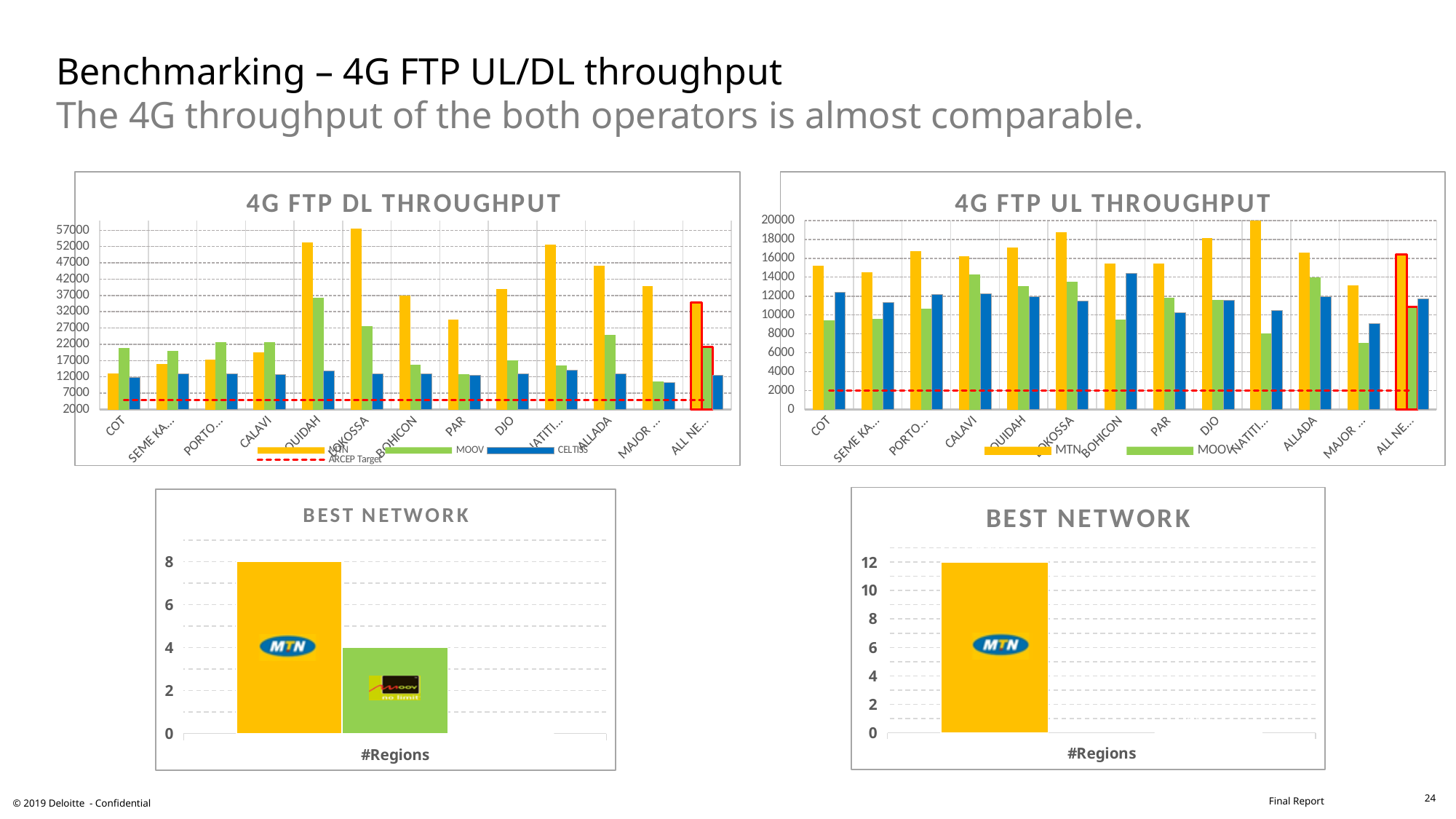
In the 4G FTP UL THROUGHPUT chart, is the MOOV value for ALLADA greater or less than 12000? greater What kind of chart is the 4G FTP DL THROUGHPUT chart? combination bar and line chart In the bottom-left BEST NETWORK chart, what is the value for MTN? 8 In the 4G FTP UL THROUGHPUT chart, is the MTN value for NATITI... greater or less than 18000? greater How many series does the legend of the 4G FTP DL THROUGHPUT chart list? 4 In the 4G FTP DL THROUGHPUT chart, which is larger for COT, the MTN value or the MOOV value? MOOV In the bottom-left BEST NETWORK chart, what is the value for MOOV? 4 In the bottom-right BEST NETWORK chart, what is the value for MTN? 12 In the 4G FTP DL THROUGHPUT chart, which operator has the highest value for OUIDAH? MTN In the bottom-left BEST NETWORK chart, what is the difference between the MTN and MOOV values? 4 In the 4G FTP UL THROUGHPUT chart, which is larger for BOHICON, the MTN value or the MOOV value? MTN